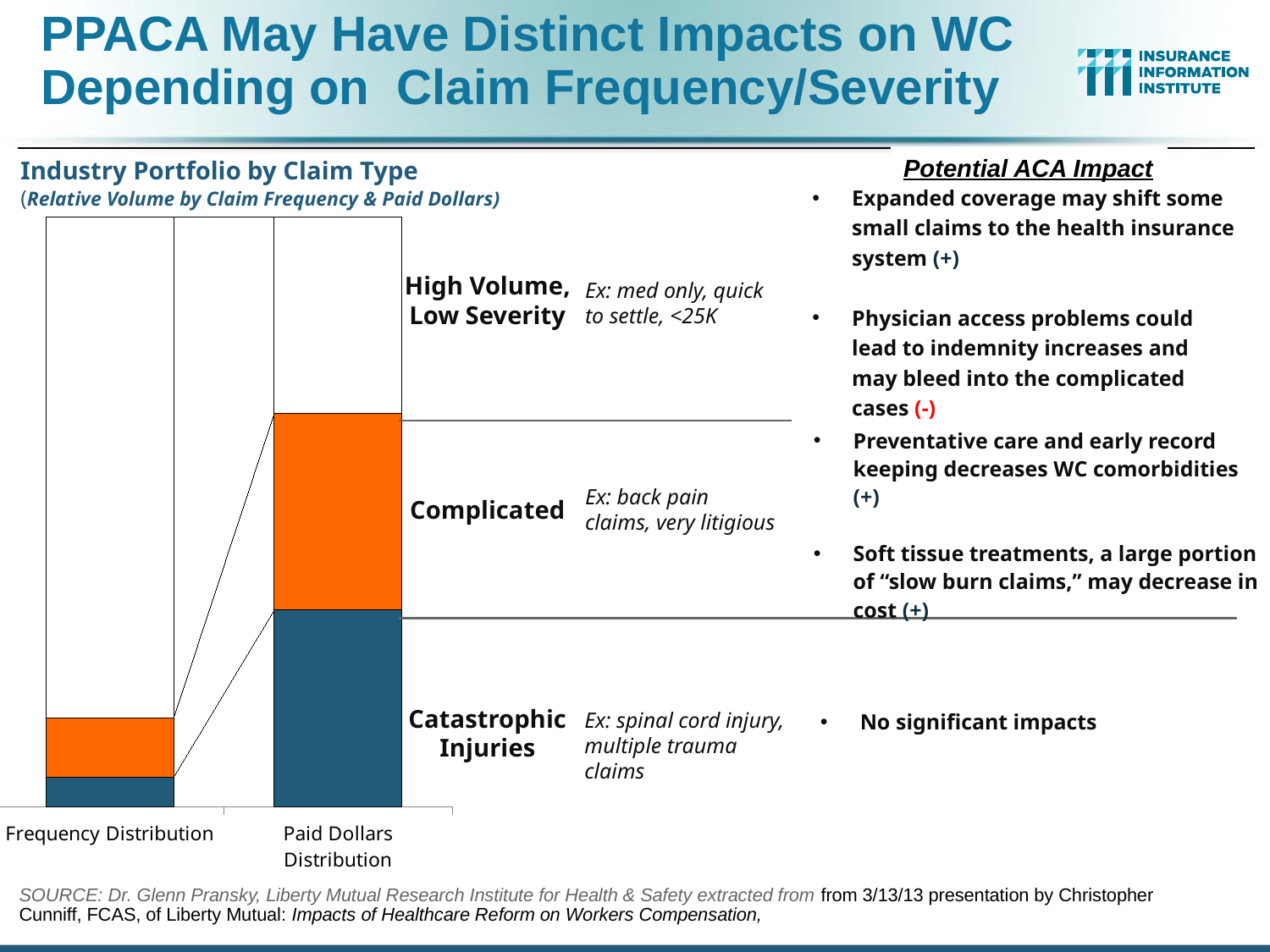
What kind of chart is shown on the slide? Stacked bar chart Is the Catastrophic Injuries segment larger in the Frequency Distribution bar or the Paid Dollars Distribution bar? Paid Dollars Distribution What colour is the Complicated segment in the chart? Orange Is the High Volume, Low Severity segment larger in the Frequency Distribution bar or the Paid Dollars Distribution bar? Frequency Distribution How many bars (distributions) does the chart show? 2 Which claim type accounts for the smallest share of the Frequency Distribution bar? Catastrophic Injuries How many claim types are stacked in each bar of the chart? 3 Moving from the Frequency Distribution bar to the Paid Dollars Distribution bar, does the share of Catastrophic Injuries rise or fall? Rise What is the title of the chart? Industry Portfolio by Claim Type Is the Complicated segment larger in the Frequency Distribution bar or the Paid Dollars Distribution bar? Paid Dollars Distribution Which claim type accounts for the largest share of the Frequency Distribution bar? High Volume, Low Severity